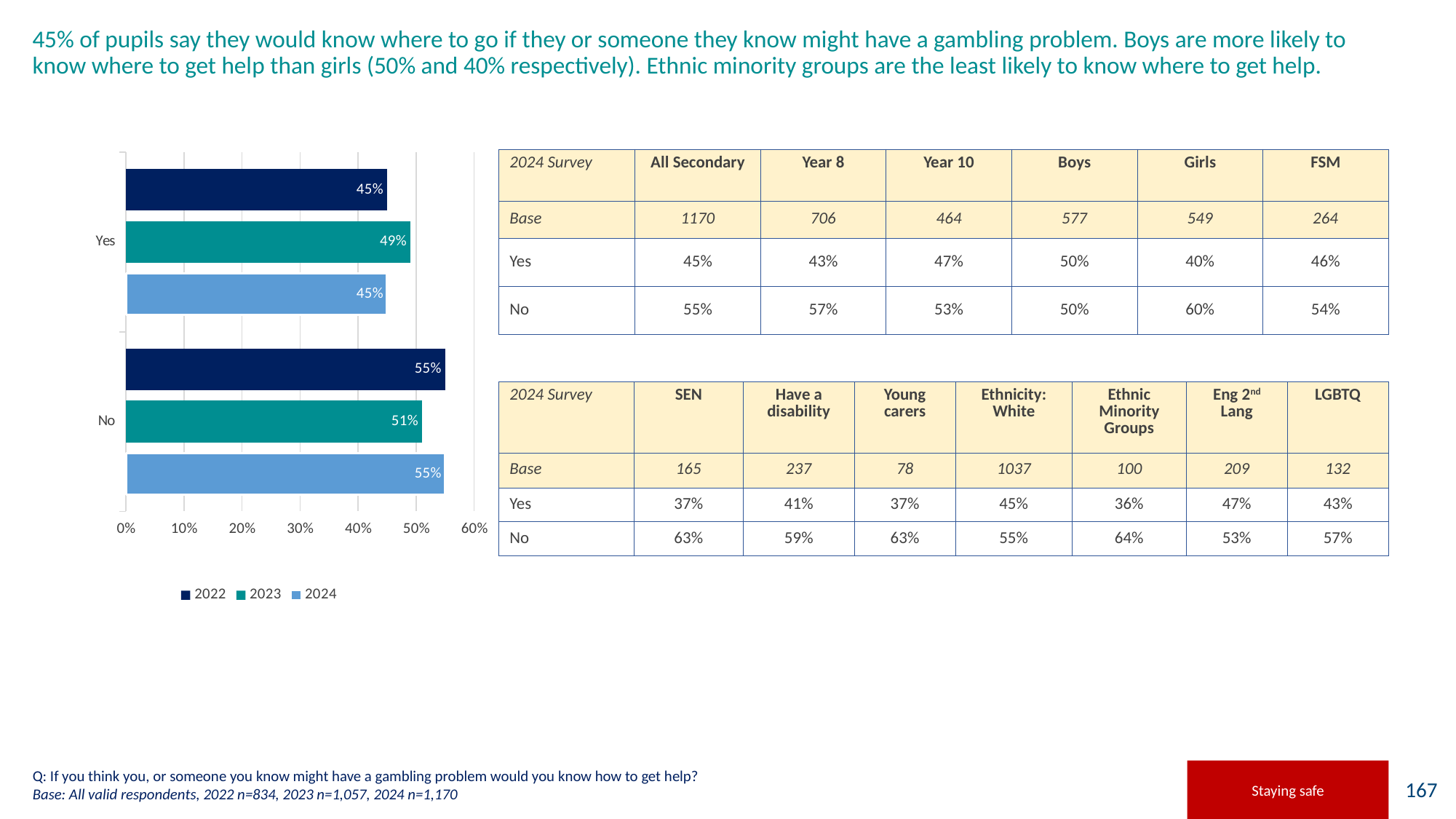
How many series does the chart legend list? 3 Which year has the lowest value for No? 2023 What is the value for No in 2023? 51% What is the value for Yes in 2023? 49% How many categories are shown on the y axis of the chart? 2 What is the value for No in 2024? 55% What kind of chart is shown on the slide? bar chart What is the value for Yes in 2022? 45% Which series is shown in the darkest blue colour in the chart? 2022 Which is larger, the Yes value for 2023 or the Yes value for 2024? 2023 Which year has the highest value for Yes? 2023 What is the difference between the No and Yes values for 2024? 10%